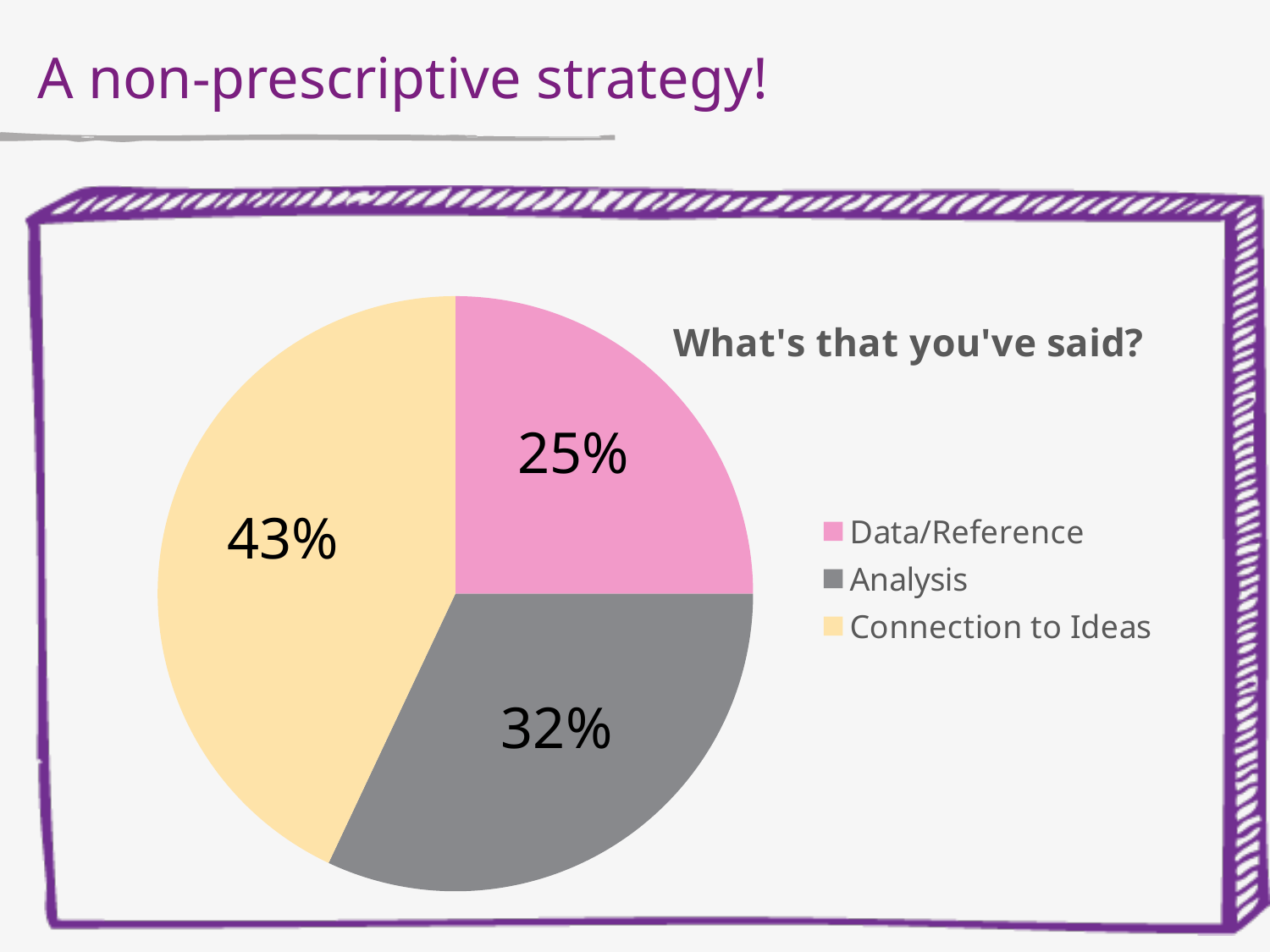
What is the difference in percentage points between Connection to Ideas and Data/Reference? 18 What is the difference in percentage points between Analysis and Data/Reference? 7 What is the title of the chart? What's that you've said? Which category has the largest slice of the pie? Connection to Ideas What is the value shown for Analysis? 32% Which is larger, Analysis or Data/Reference? Analysis How many categories are shown in the pie chart? 3 What kind of chart is shown on the slide? Pie chart Which colour represents Analysis in the legend? Grey What share of the pie does Connection to Ideas represent? 43% What is the value shown for Data/Reference? 25% Which category has the smallest slice of the pie? Data/Reference